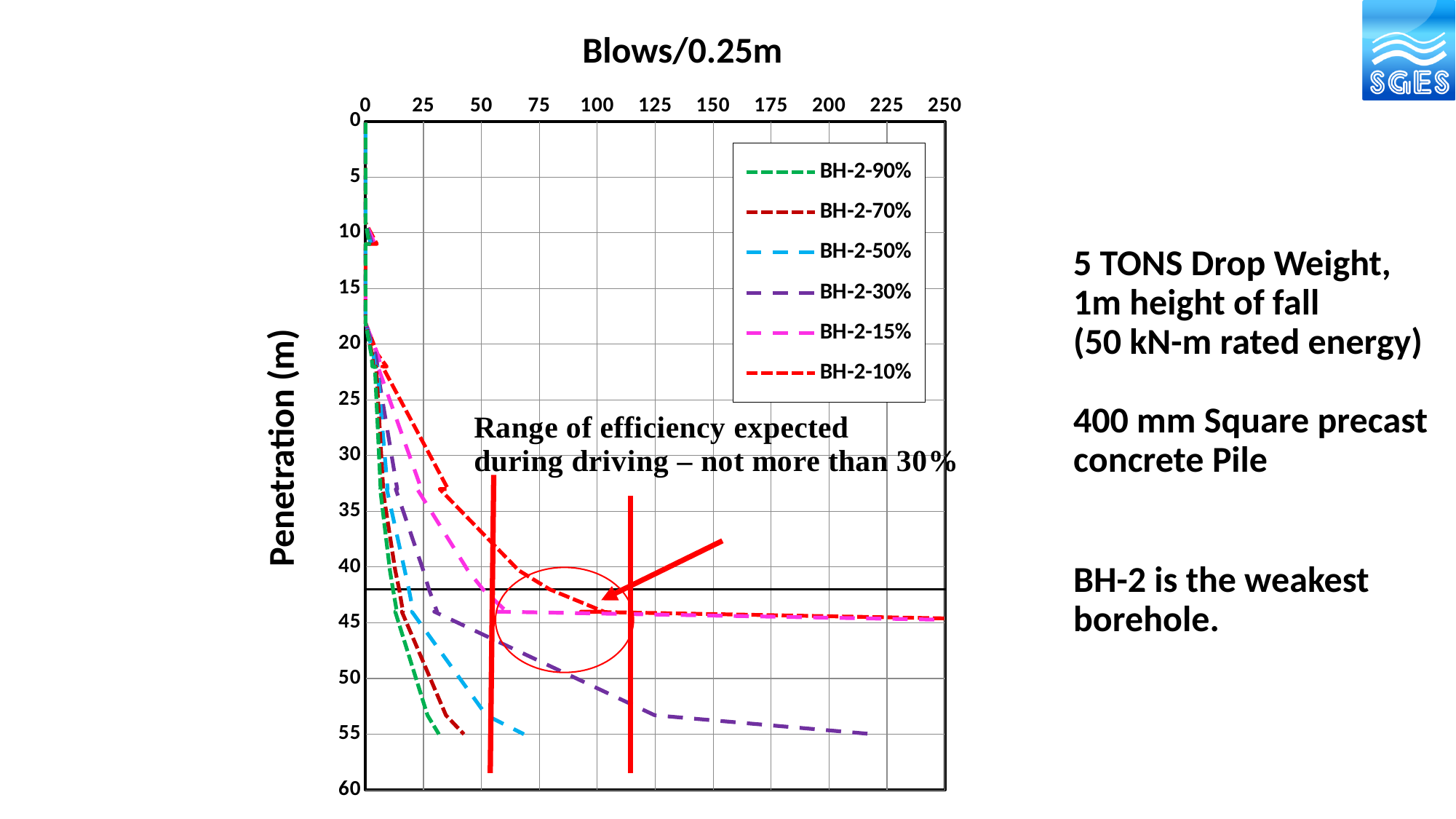
How many series does the legend list? 6 What is the label of the vertical axis? Penetration (m) What is the title shown above the chart's horizontal axis? Blows/0.25m Which series has the lowest blow counts across the penetration depths? BH-2-90% At 50 m penetration, which series has the larger blow count, BH-2-30% or BH-2-50%? BH-2-30% Is the value for BH-2-90% at 55 m penetration greater or less than 50 blows/0.25m? less What kind of chart is shown on the slide? line chart Is the value for BH-2-30% at 55 m penetration greater or less than 200 blows/0.25m? greater Is the value for BH-2-50% at 55 m penetration greater or less than 50 blows/0.25m? greater At 40 m penetration, which series has the larger blow count, BH-2-10% or BH-2-90%? BH-2-10% Do the blow counts rise or fall as penetration depth increases? rise